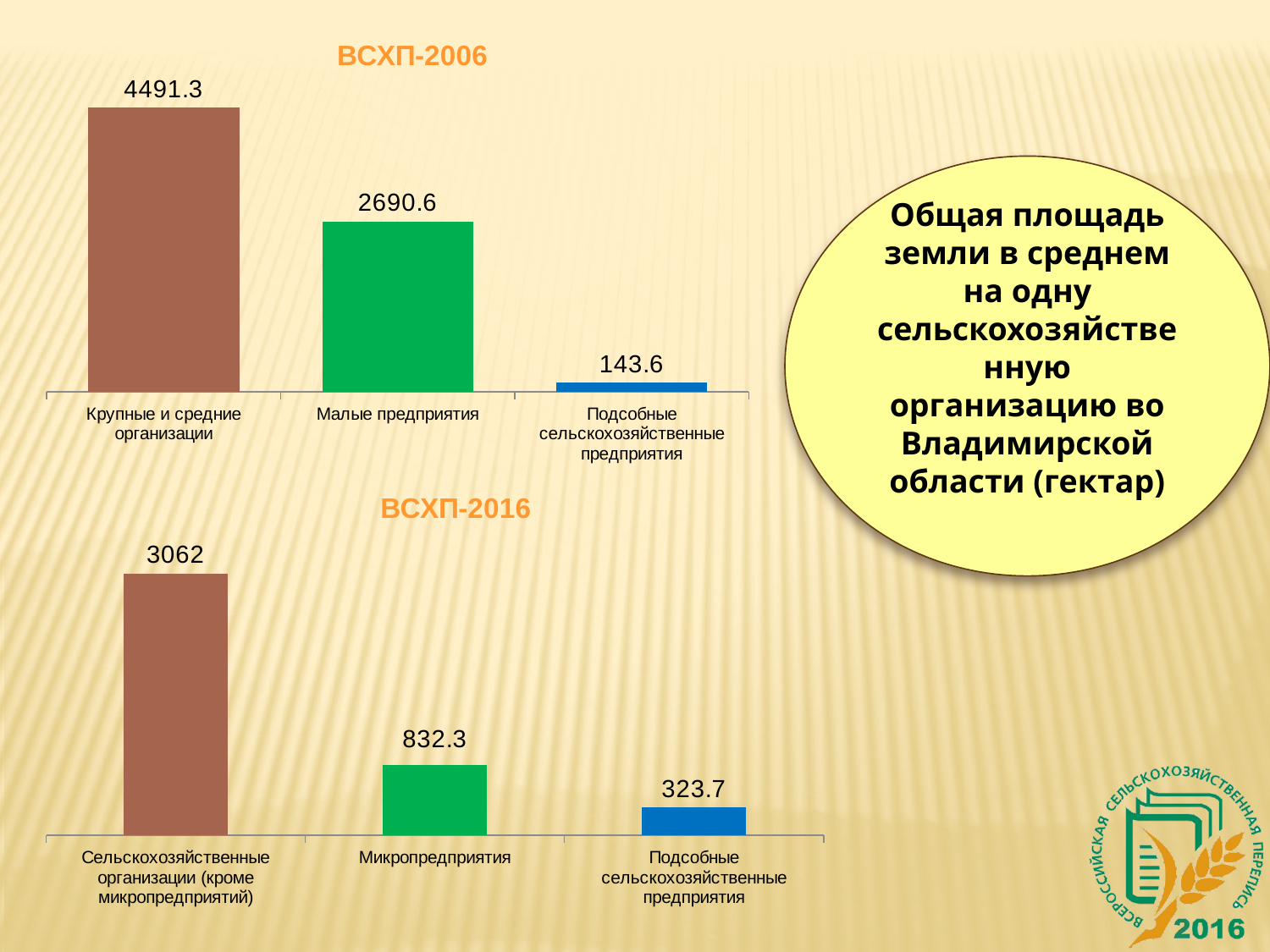
In the ВСХП-2016 chart, which category has the highest value? Сельскохозяйственные организации (кроме микропредприятий) Is the value for Подсобные сельскохозяйственные предприятия larger in the ВСХП-2006 chart or in the ВСХП-2016 chart? ВСХП-2016 In the ВСХП-2006 chart, which category has the lowest value? Подсобные сельскохозяйственные предприятия In the ВСХП-2006 chart, what is the difference between the values for Крупные и средние организации and Малые предприятия? 1800.7 What type of chart is the ВСХП-2006 chart? Bar chart In the ВСХП-2016 chart, what is the difference between the values for Микропредприятия and Подсобные сельскохозяйственные предприятия? 508.6 How many categories are shown in the ВСХП-2016 chart? 3 In the ВСХП-2006 chart, what is the value for Крупные и средние организации? 4491.3 In the ВСХП-2016 chart, what is the value for Микропредприятия? 832.3 In the ВСХП-2006 chart, what is the value for Малые предприятия? 2690.6 In the ВСХП-2016 chart, what is the value for Подсобные сельскохозяйственные предприятия? 323.7 In the ВСХП-2006 chart, do the values rise or fall from left to right? Fall